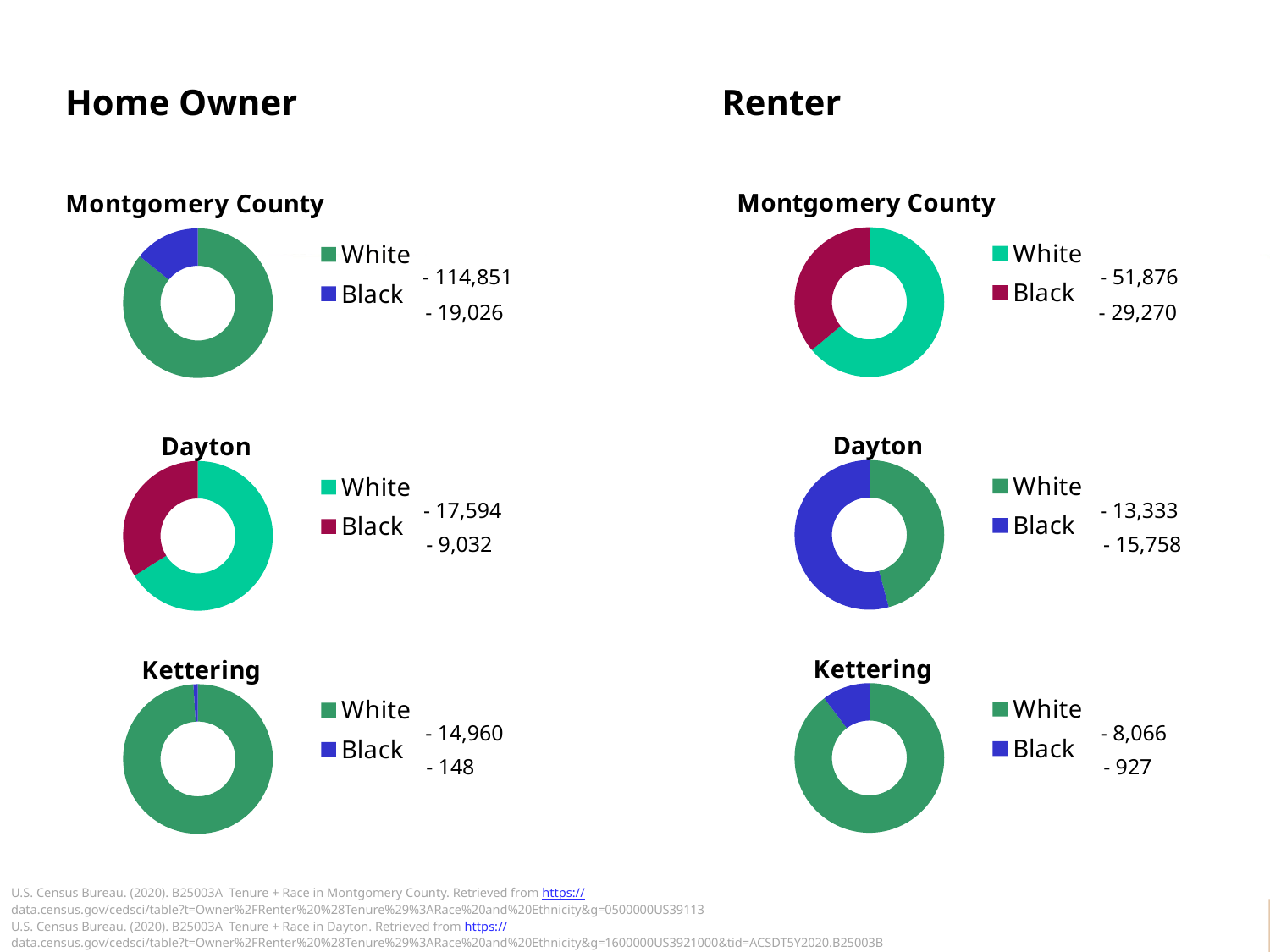
In the Home Owner Montgomery County chart, what is the value for White? 114,851 What kind of chart is used for the Renter Montgomery County data? Donut (pie) chart In the Home Owner Kettering chart, which category is the smallest? Black In the Home Owner Montgomery County chart, what is the difference between the White and Black values? 95,825 In the Home Owner Kettering chart, what is the total of the White and Black values? 15,108 In the Renter Kettering chart, what is the value for White? 8,066 How many donut charts are shown on the slide in total? 6 In the Renter Montgomery County chart, what is the value for Black? 29,270 In the Renter Dayton chart, which category is larger, White or Black? Black How many categories does the legend of the Home Owner Dayton chart list? 2 In the Home Owner Dayton chart, what is the value for Black? 9,032 In the Renter Dayton chart, what is the difference between the Black and White values? 2,425